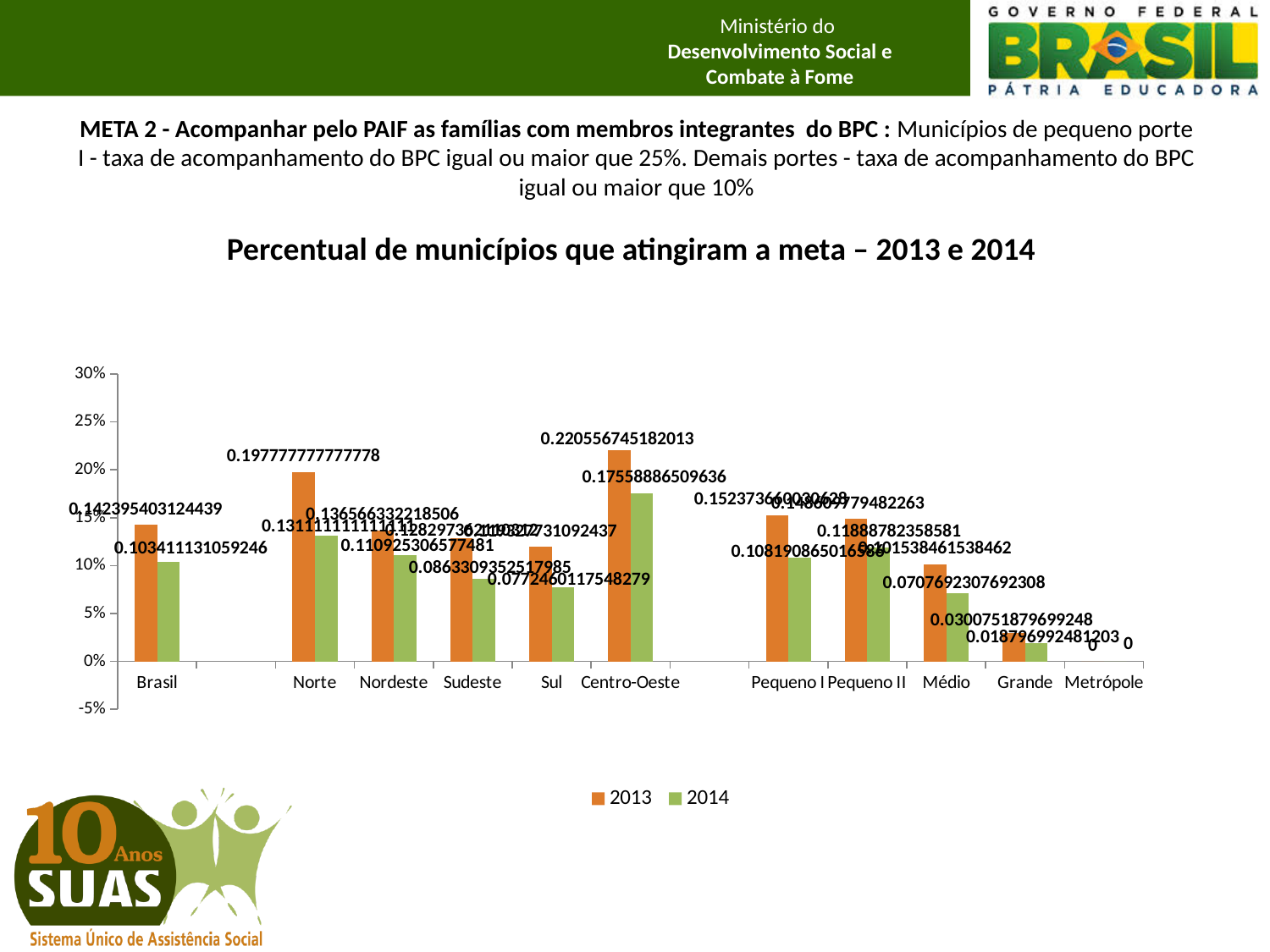
What is the difference between the 2013 and 2014 values for Centro-Oeste? 0.044967880085653 How many categories are shown on the x axis of the chart? 11 For Brasil, which is larger: the 2013 value or the 2014 value? 2013 How many series does the legend list? 2 What is the 2013 value for Centro-Oeste? 0.220556745182013 Which category has the highest 2013 value? Centro-Oeste What is the 2014 value for Brasil? 0.103411131059246 What type of chart is shown on the slide? bar chart What is the 2014 value for Grande? 0.018796992481203 What is the 2013 value for Brasil? 0.142395403124439 Which category has the lowest values, with both 2013 and 2014 equal to 0? Metrópole Is the 2013 value for Norte greater or less than 15%? greater